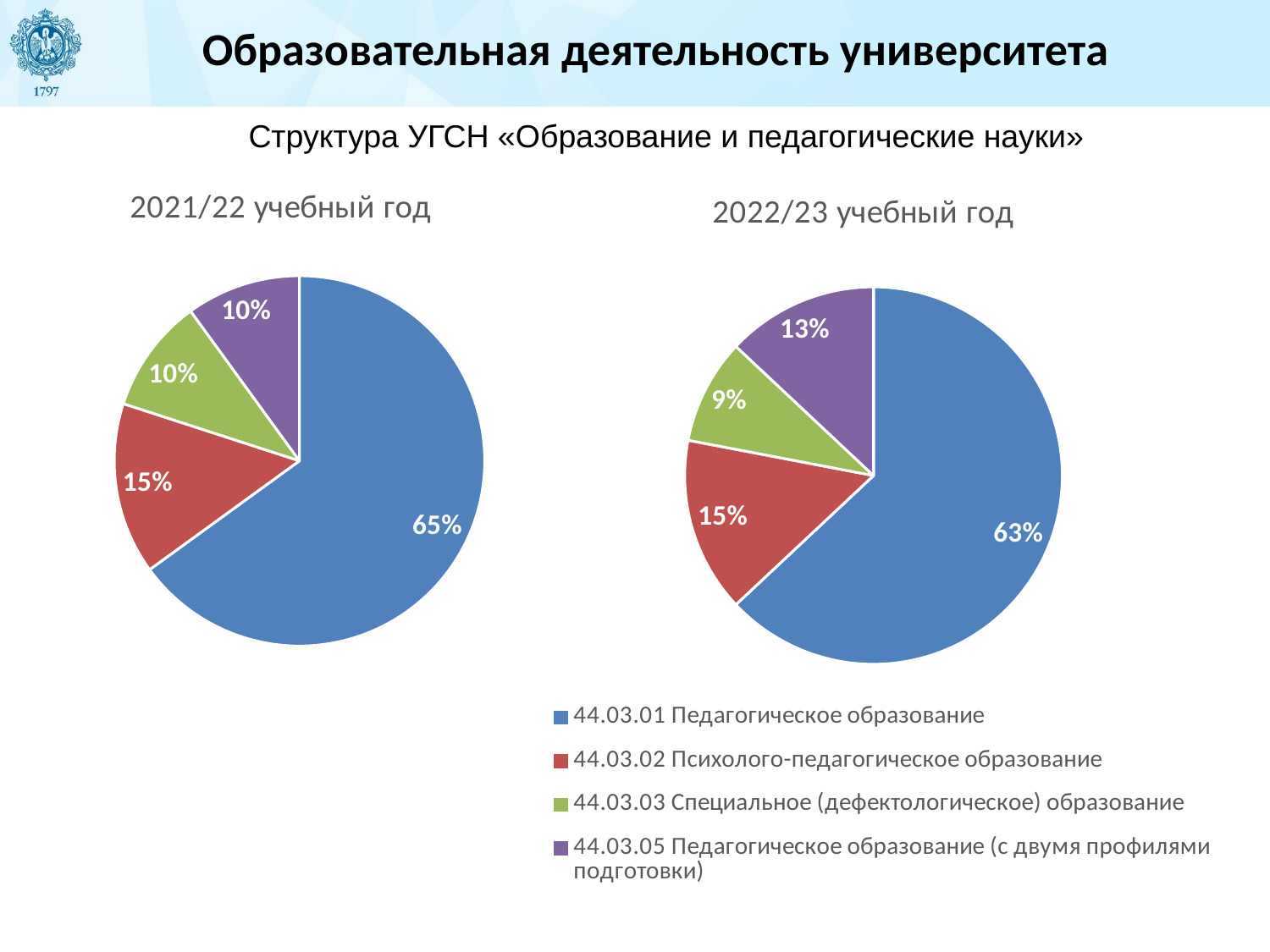
How many slices does the "2021/22 учебный год" chart have? 4 In the "2021/22 учебный год" chart, which category has the largest slice? 44.03.01 Педагогическое образование In the "2022/23 учебный год" chart, what share does 44.03.03 Специальное (дефектологическое) образование have? 9% In the "2022/23 учебный год" chart, which is larger: the slice for 44.03.02 Психолого-педагогическое образование or the slice for 44.03.05 Педагогическое образование (с двумя профилями подготовки)? 44.03.02 Психолого-педагогическое образование In the "2022/23 учебный год" chart, what share does 44.03.05 Педагогическое образование (с двумя профилями подготовки) have? 13% How many entries does the legend list? 4 In the "2021/22 учебный год" chart, what share does 44.03.02 Психолого-педагогическое образование have? 15% What is the difference between the share of 44.03.01 Педагогическое образование in the "2021/22 учебный год" chart and in the "2022/23 учебный год" chart? 2% In the "2022/23 учебный год" chart, which category has the smallest slice? 44.03.03 Специальное (дефектологическое) образование What type of chart is used for "2022/23 учебный год"? Pie chart